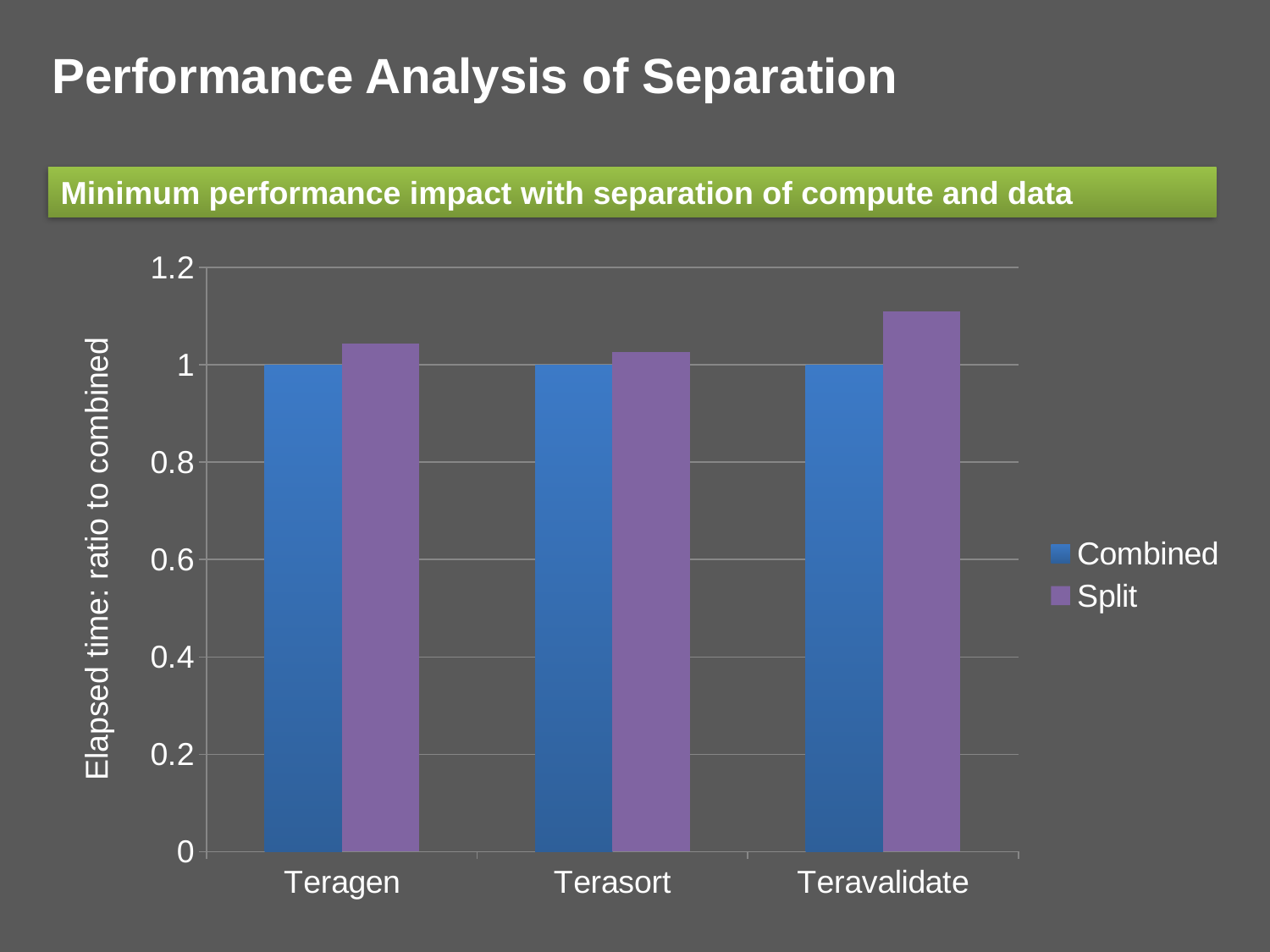
Which is larger: the Split value for Teravalidate or the Split value for Terasort? Teravalidate What is the value of the Combined series for Teravalidate? 1 What is the value of the Combined series for Terasort? 1 Is the Split value for Teragen greater or less than 1.2? less What type of chart is shown on the slide? bar chart For Teravalidate, which series has the larger value, Combined or Split? Split How many series does the chart legend list? 2 Which category has the highest value for the Split series? Teravalidate Is the Split value for Teravalidate greater or less than 1? greater What is the label on the vertical axis of the chart? Elapsed time: ratio to combined What is the value of the Combined series for Teragen? 1 How many categories are shown on the x axis of the chart? 3